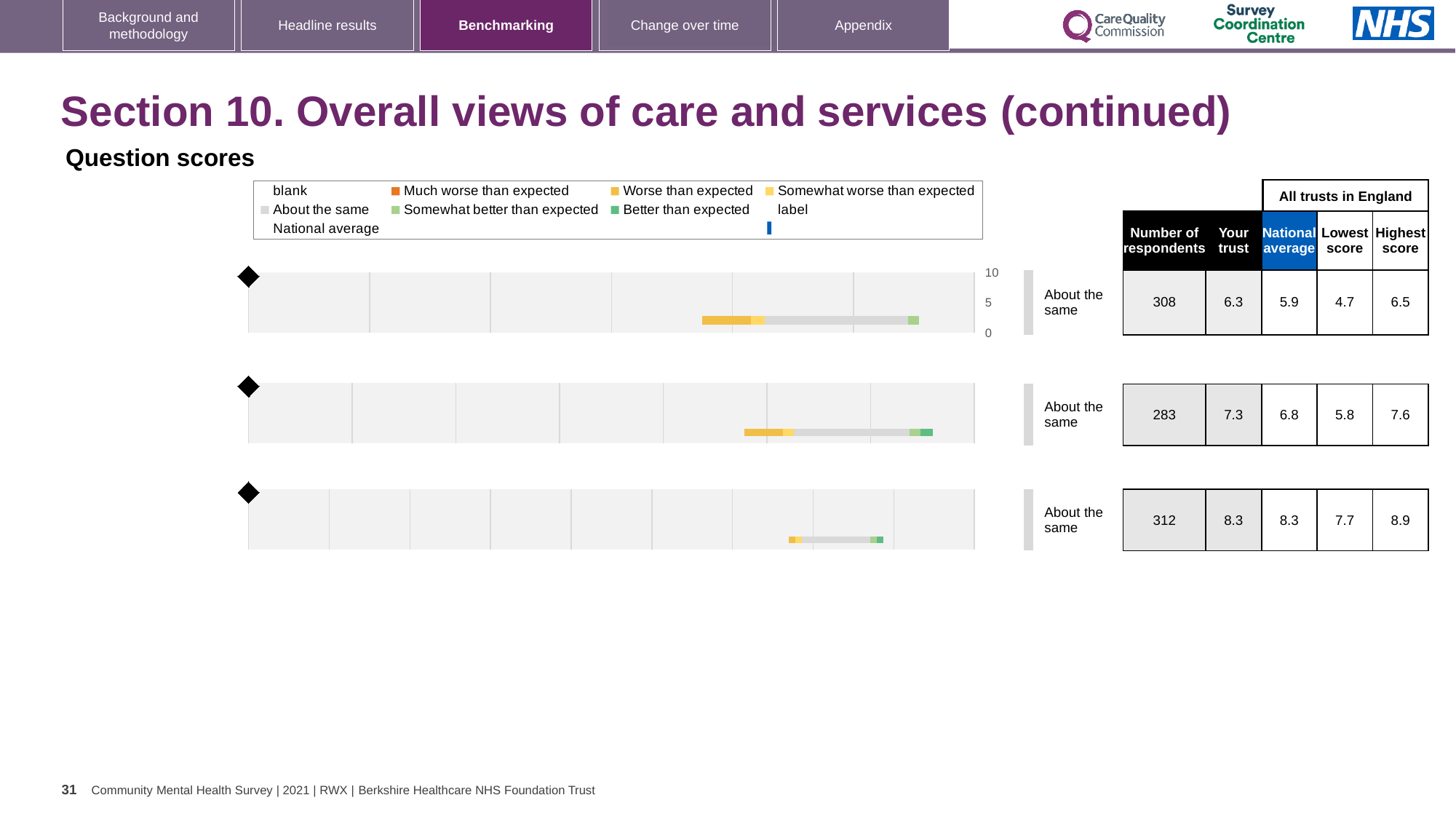
For the middle chart, what is the difference between the highest score and the lowest score? 1.8 For the top chart, what is the national average score? 5.9 What kind of chart is used for the three benchmarking charts on the slide? Bar chart How many benchmarking charts are shown on the slide? 3 For the middle chart, how many respondents are listed? 283 Which of the three charts has the lowest number of respondents? The middle chart (283) Which of the three charts has the highest 'Your trust' score? The bottom chart (8.3) What benchmark category is shown next to each of the three charts? About the same For the top chart, what is the 'Your trust' score shown in the table? 6.3 In the legend, what colour represents 'Much worse than expected'? Orange For the bottom chart, what is the highest score among all trusts in England? 8.9 For the top chart, which is larger: the 'Your trust' score or the national average? Your trust